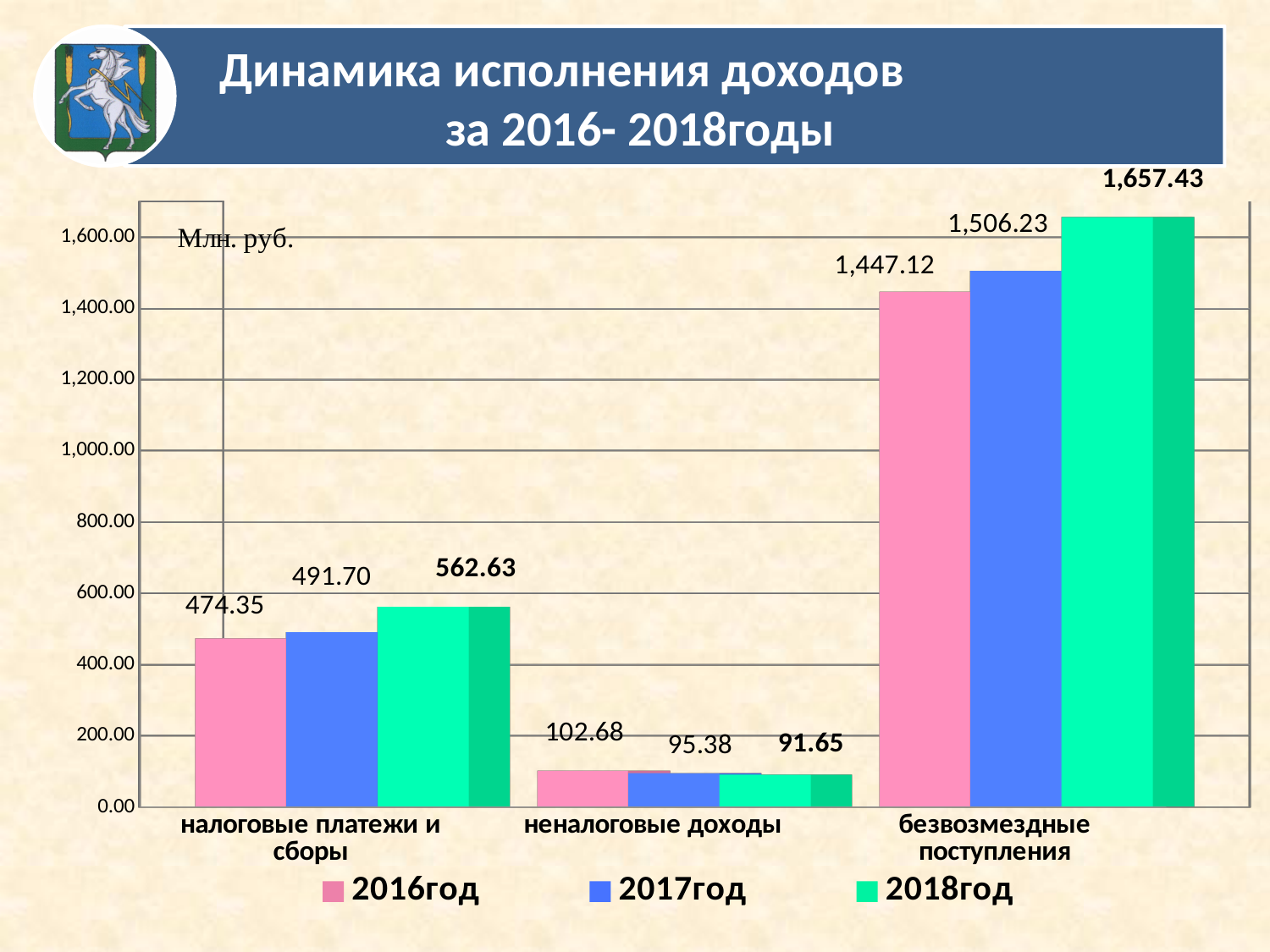
Is the 2017год value for безвозмездные поступления greater or less than 1,400.00? greater Which category has the lowest value for 2016год? неналоговые доходы How many categories are shown on the x axis? 3 Which is larger for неналоговые доходы: the 2016год value or the 2018год value? 2016год What is the value for 2018год in the category безвозмездные поступления? 1,657.43 Which category has the highest value for 2018год? безвозмездные поступления What is the value for 2017год in the category неналоговые доходы? 95.38 What is the difference between the 2018год and 2016год values for налоговые платежи и сборы? 88.28 Do the values for неналоговые доходы rise or fall from 2016год to 2018год? fall What is the difference between the 2018год and 2017год values for безвозмездные поступления? 151.20 How many series does the legend list? 3 What is the value for 2016год in the category налоговые платежи и сборы? 474.35